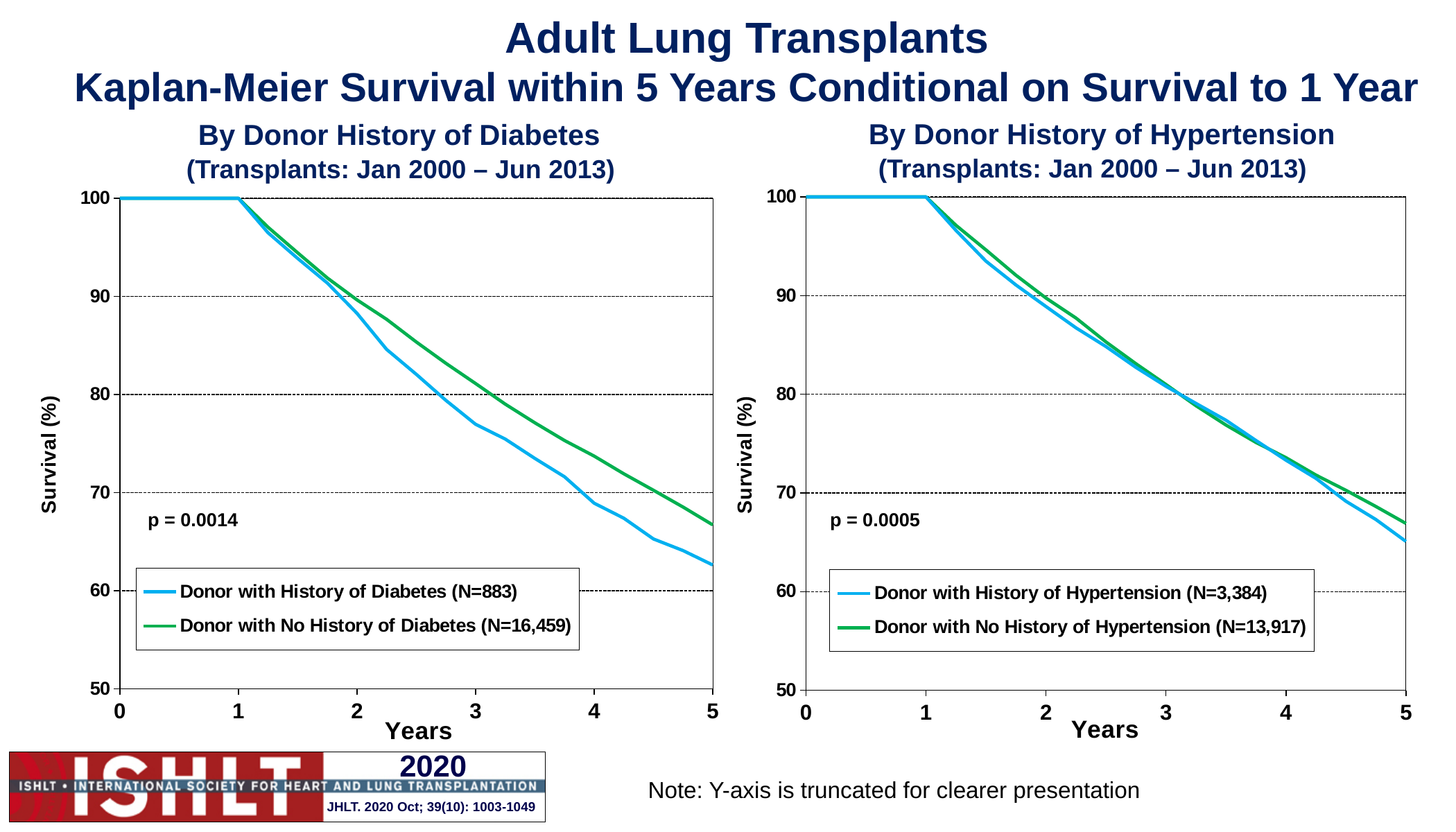
What is the N for the 'Donor with History of Hypertension' series in the 'By Donor History of Hypertension' chart? N=3,384 In the 'By Donor History of Hypertension' chart, is the survival value for donors with a history of hypertension at year 5 greater or less than 70? less What p-value is shown on the 'By Donor History of Diabetes' chart? p = 0.0014 In the 'By Donor History of Diabetes' chart, do the survival curves rise or fall as years increase? fall In the 'By Donor History of Hypertension' chart, which series has higher survival at year 2? Donor with No History of Hypertension In the 'By Donor History of Diabetes' chart, which series has higher survival at year 3? Donor with No History of Diabetes What kind of chart is the 'By Donor History of Diabetes' chart? line chart How many series does the legend of the 'By Donor History of Hypertension' chart list? 2 In the 'By Donor History of Diabetes' chart, is the survival value for donors with a history of diabetes at year 3 greater or less than 80? less In the 'By Donor History of Hypertension' chart, is the survival value for donors with no history of hypertension at year 4 greater or less than 70? greater